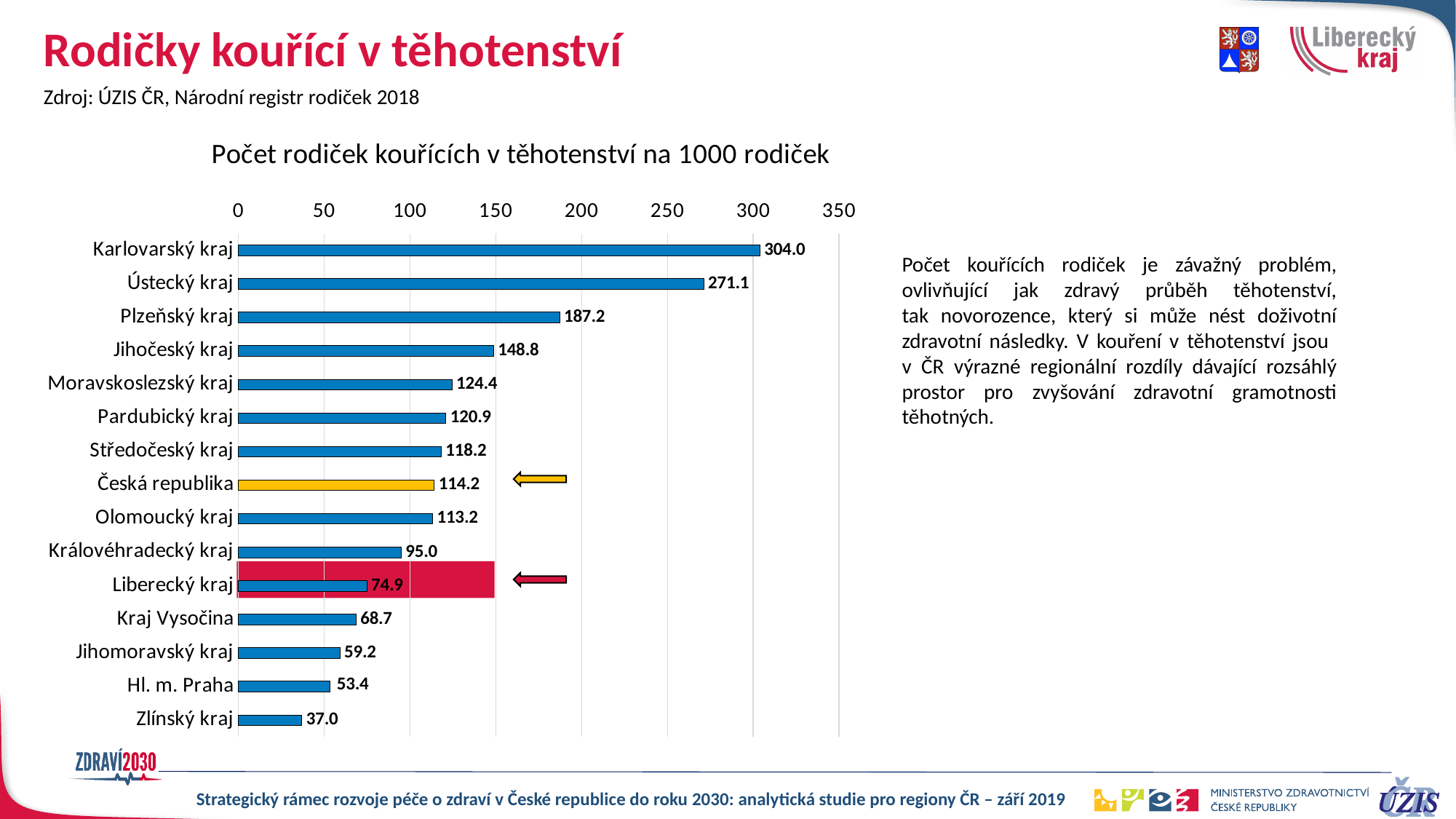
What is the title of the chart? Počet rodiček kouřících v těhotenství na 1000 rodiček What kind of chart is shown on the slide? bar chart What is the difference between the values for Karlovarský kraj and Ústecký kraj? 32.9 What is the difference between the values for Česká republika and Liberecký kraj? 39.3 Which category has the highest value? Karlovarský kraj What is the value for Česká republika? 114.2 How many categories are shown on the chart? 15 Which category has the lowest value? Zlínský kraj Which is larger, the value for Plzeňský kraj or the value for Jihočeský kraj? Plzeňský kraj Is the value for Moravskoslezský kraj greater or less than 100? greater What is the value for Liberecký kraj? 74.9 What is the value for Karlovarský kraj? 304.0